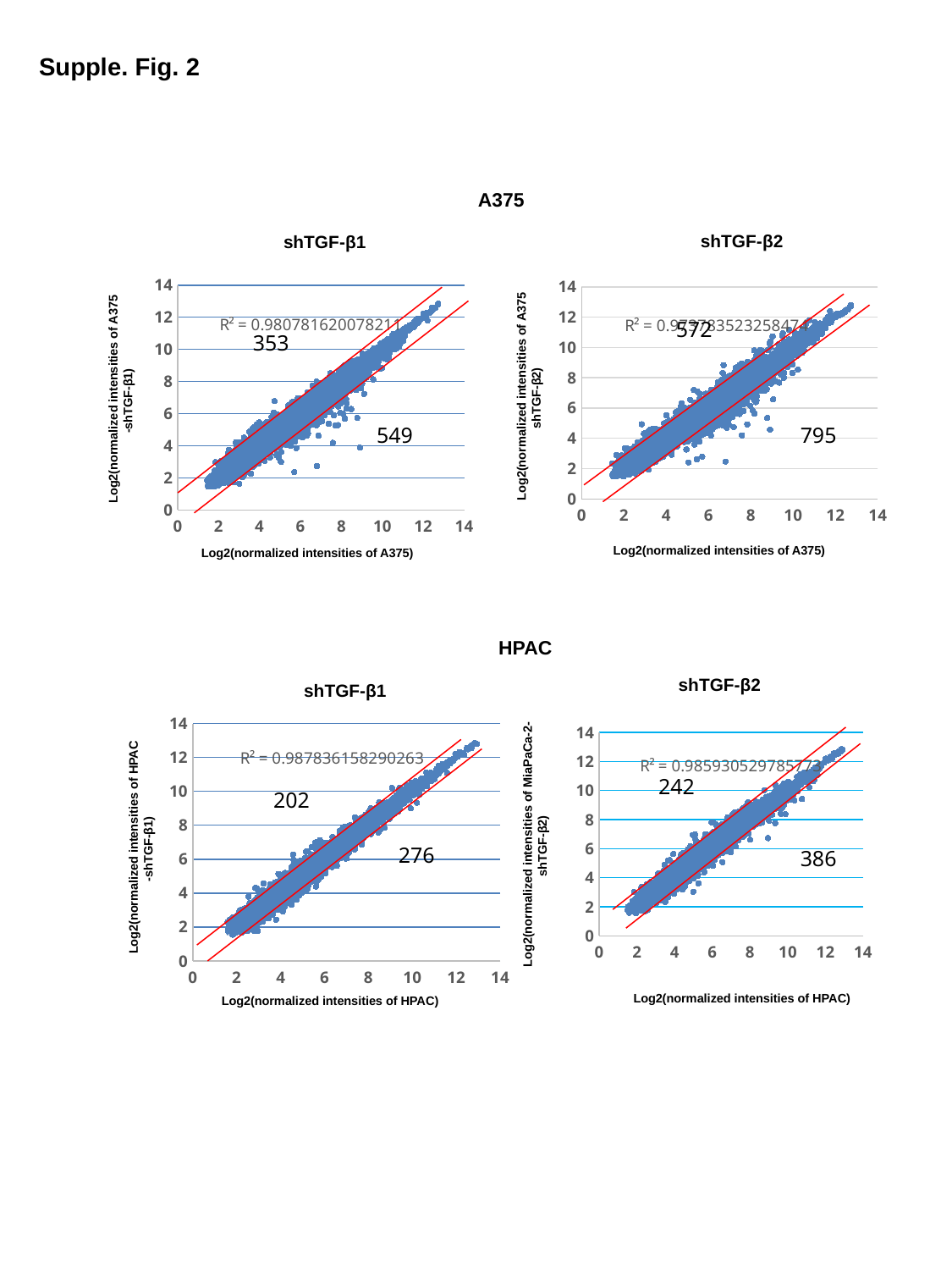
In the A375 shTGF-β1 chart (top left), what number is printed above the red lines in the upper left of the plot? 353 In the HPAC shTGF-β1 chart (bottom left), what is the difference between the two printed counts, 276 and 202? 74 In the HPAC shTGF-β2 chart (bottom right), what number is printed below the red lines in the lower right of the plot? 386 What is the x-axis label of the A375 shTGF-β1 chart (top left)? Log2(normalized intensities of A375) What kind of chart is the A375 shTGF-β1 chart (top left)? Scatter plot How many charts are shown on the slide? 4 Which printed count is larger: 549 in the A375 shTGF-β1 chart or 795 in the A375 shTGF-β2 chart? 795 in the A375 shTGF-β2 chart In the A375 shTGF-β2 chart (top right), what is the difference between the two printed counts, 795 and 572? 223 In the HPAC shTGF-β1 chart (bottom left), what R² value is printed? R² = 0.987836158290263 In the A375 shTGF-β2 chart (top right), what number is printed below the red lines in the lower right of the plot? 795 In the A375 shTGF-β1 chart (top left), what R² value is printed? R² = 0.980781620078211 In the HPAC shTGF-β1 chart (bottom left), do the plotted points rise or fall as the x-axis value increases? Rise